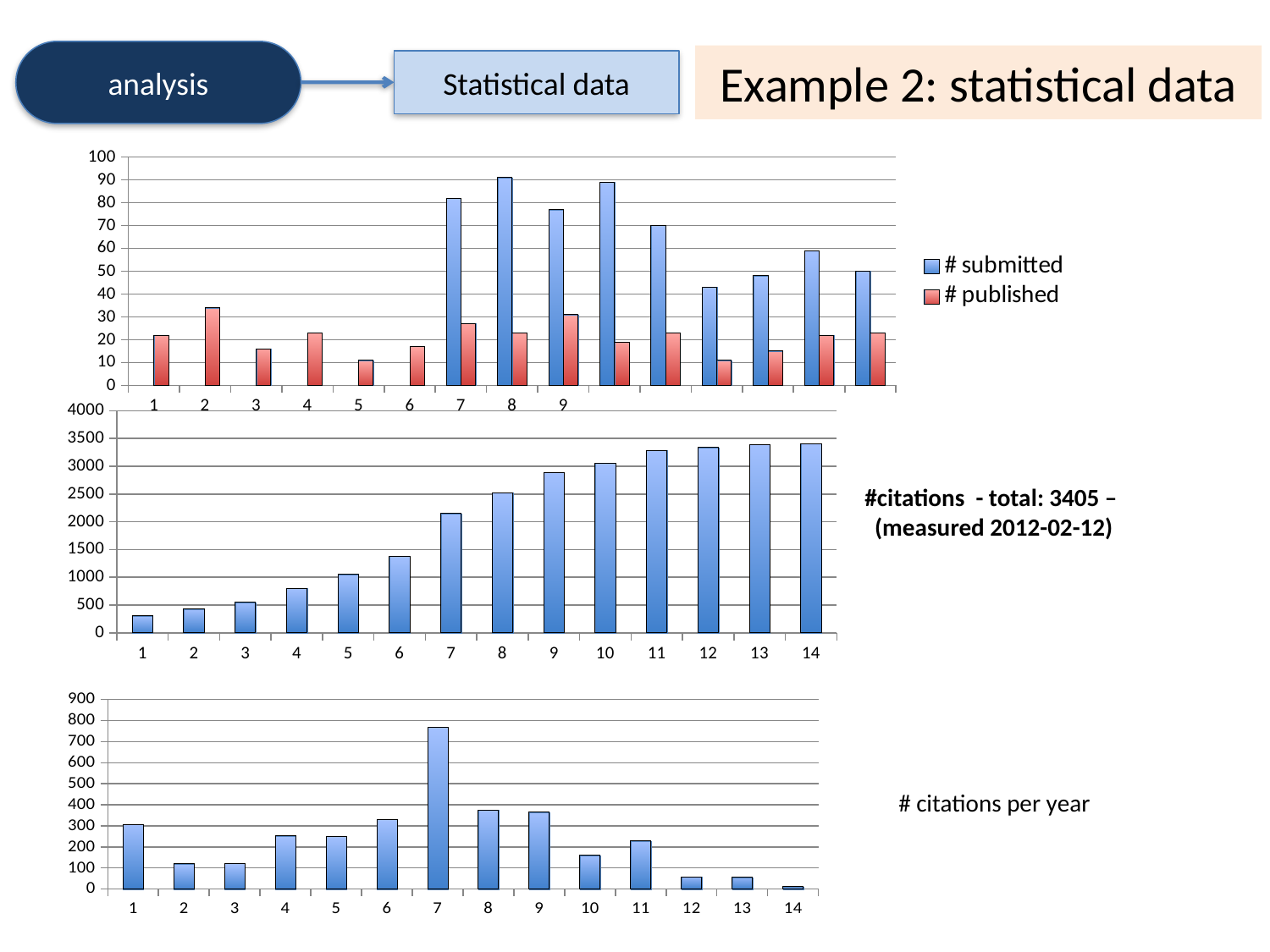
In the bottom chart (# citations per year), which is larger, the value for category 6 or category 4? category 6 In the bottom chart (# citations per year), which category has the lowest value? 14 In the bottom chart (# citations per year), which category has the highest value? 7 In the middle chart, is the value for category 6 greater or less than 1500? less What are the two series named in the legend of the top chart? # submitted and # published How many series does the legend of the top chart list? 2 In the top chart, is the # published value for category 5 greater or less than 20? less What type of chart is the top chart on the slide? bar chart In the middle chart, which category has the lowest value? 1 In the top chart, is the # submitted value for category 8 greater or less than 80? greater In the middle chart, do the values rise or fall from category 1 to category 14? rise How many categories are shown on the x axis of the middle chart? 14